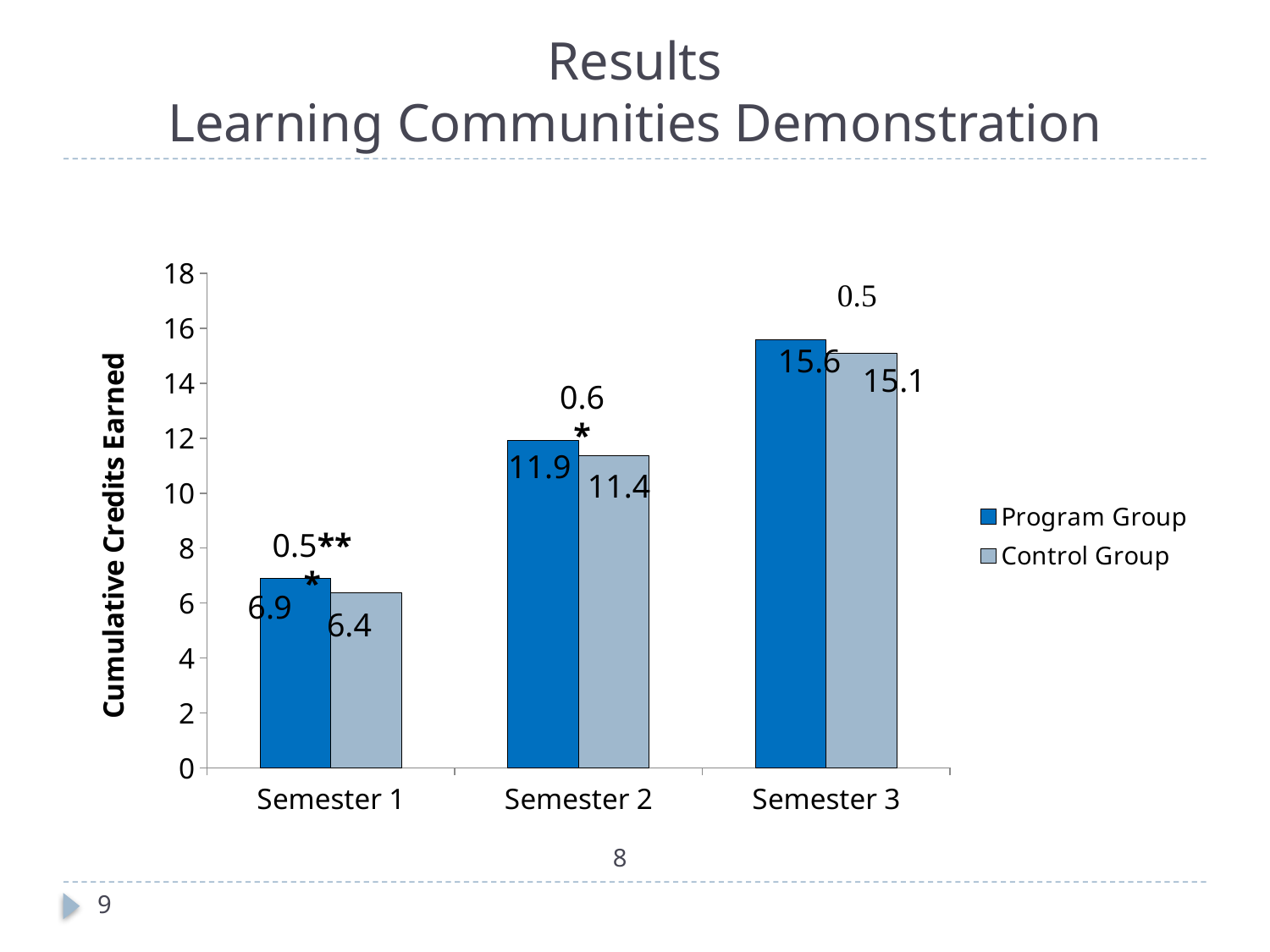
What is the value for the Program Group in Semester 3? 15.6 What is the value for the Program Group in Semester 1? 6.9 How many semesters are shown on the x axis? 3 In which semester is the Control Group value lowest? Semester 1 What kind of chart is shown on the slide? Bar chart What is the value for the Control Group in Semester 2? 11.4 What is the difference between the Program Group and Control Group values in Semester 2? 0.6 In which semester is the Program Group value highest? Semester 3 Do the Program Group values rise or fall from Semester 1 to Semester 3? Rise What is the value for the Control Group in Semester 3? 15.1 How many series does the legend list? 2 Which is larger in Semester 1, the Program Group value or the Control Group value? Program Group